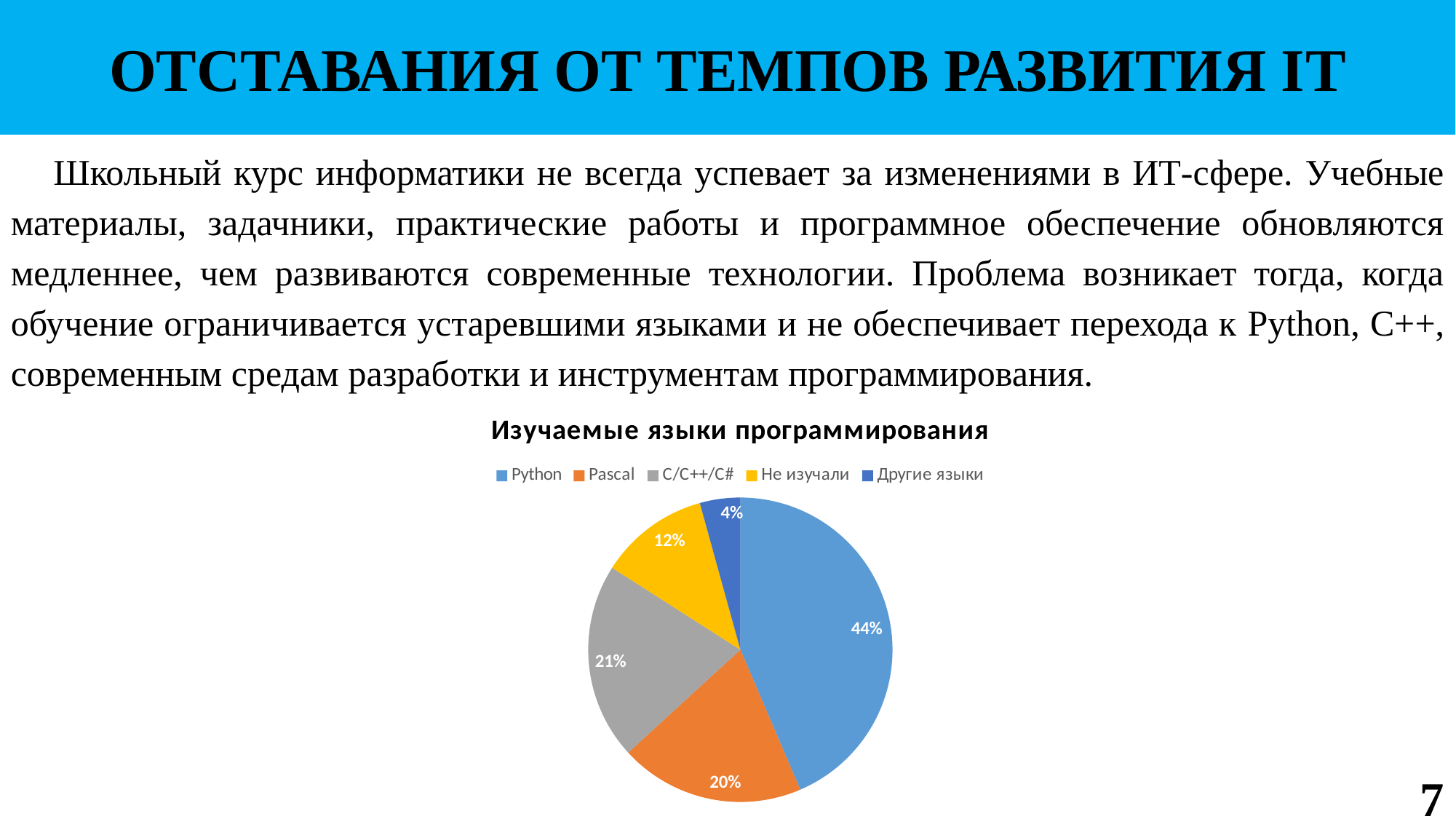
Which is larger, the share for Python or the share for Не изучали? Python What is the value for Не изучали? 12% Which category has the largest slice? Python What is the difference between the Python share and the Pascal share? 24% What is the title of the chart? Изучаемые языки программирования Which category has the smallest slice? Другие языки What is the value for Pascal? 20% What share of the pie does Python have? 44% How many entries does the legend list? 5 What kind of chart is shown on the slide? pie chart What is the value for C/C++/C#? 21% How many slices does the pie chart have? 5